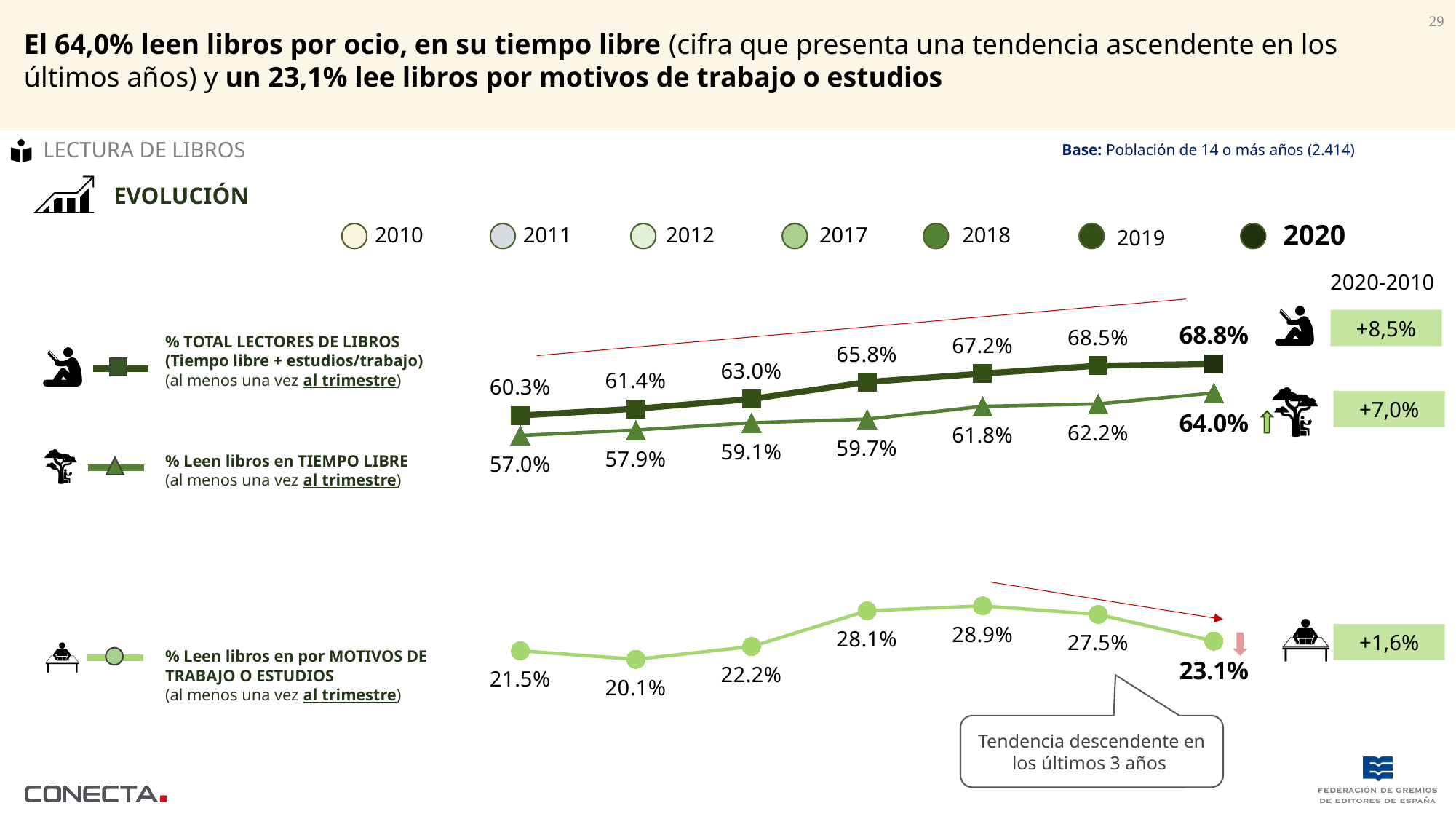
In the upper chart, do the values for % TOTAL LECTORES DE LIBROS rise or fall from 2010 to 2020? Rise What kind of chart is used on this slide? Line chart In the lower chart, what is the value for % Leen libros por MOTIVOS DE TRABAJO O ESTUDIOS in 2020? 23.1% In the upper chart, what is the value for % Leen libros en TIEMPO LIBRE in 2010? 57.0% In the lower chart, what is the value for % Leen libros por MOTIVOS DE TRABAJO O ESTUDIOS in 2018? 28.9% How many years are plotted along the x axis of the charts? 7 In the upper chart, what is the value for % TOTAL LECTORES DE LIBROS in 2020? 68.8% In the upper chart, what is the difference between the % Leen libros en TIEMPO LIBRE values for 2020 and 2019? 1.8 percentage points In the upper chart, which is larger in 2012: % TOTAL LECTORES DE LIBROS or % Leen libros en TIEMPO LIBRE? % TOTAL LECTORES DE LIBROS In the lower chart, which year has the highest value for reading for work or studies? 2018 How many series are plotted in the upper chart? 2 In the lower chart, which year has the lowest value for reading for work or studies? 2011